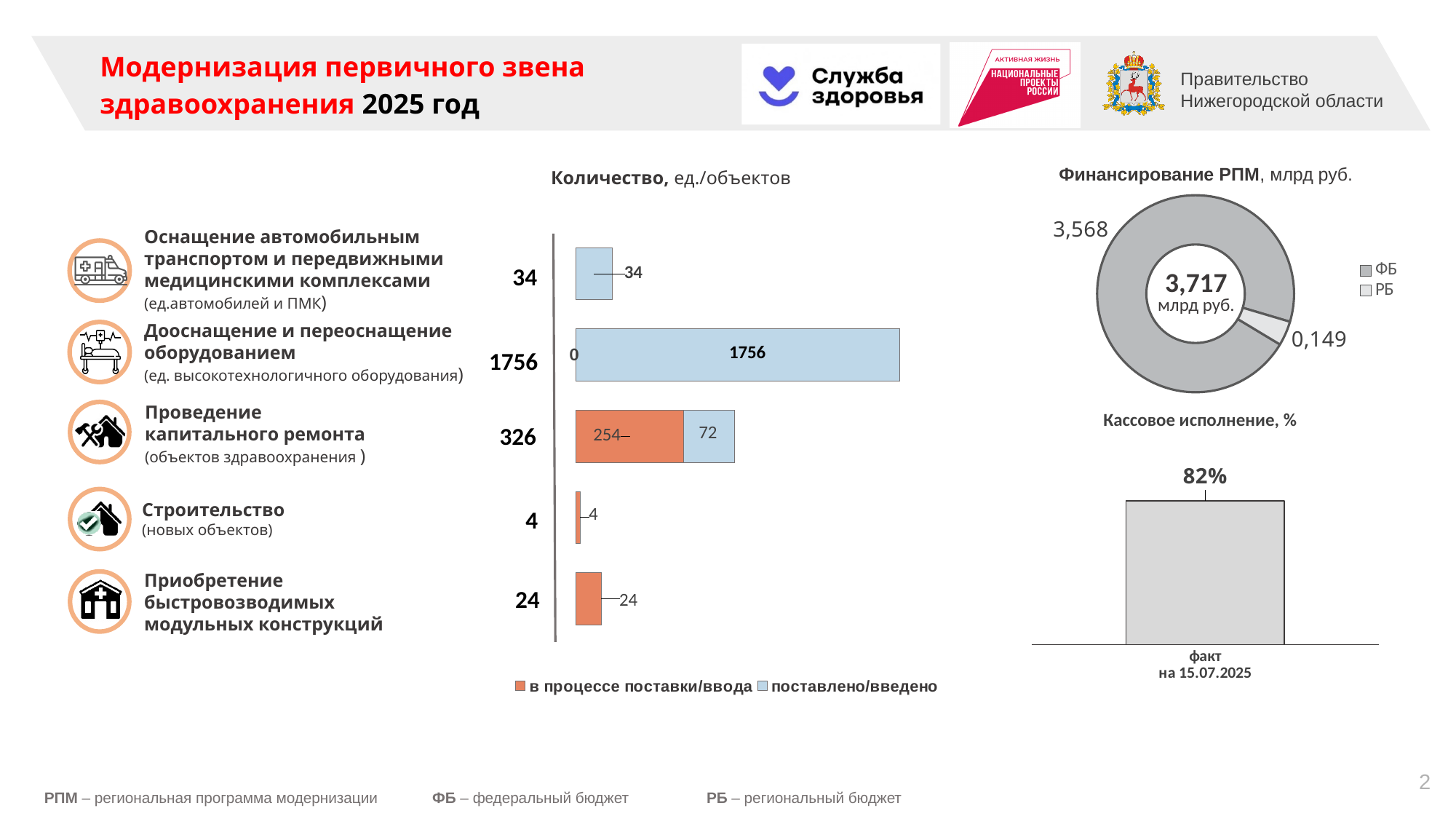
In the chart 'Финансирование РПМ, млрд руб.', what is the value for РБ? 0,149 In the chart 'Количество, ед./объектов', what is the difference between the 'в процессе поставки/ввода' and 'поставлено/введено' values for 'Проведение капитального ремонта'? 182 In the chart 'Количество, ед./объектов', what is the total of the stacked bar for 'Проведение капитального ремонта'? 326 In the chart 'Финансирование РПМ, млрд руб.', what total is shown in the centre of the donut? 3,717 млрд руб. In the chart 'Количество, ед./объектов', which category has the highest total value? Дооснащение и переоснащение оборудованием In the chart 'Количество, ед./объектов', what is the value for 'в процессе поставки/ввода' for 'Проведение капитального ремонта'? 254 In the chart 'Количество, ед./объектов', how many series does the legend list? 2 In the chart 'Количество, ед./объектов', what is the value for 'поставлено/введено' for 'Дооснащение и переоснащение оборудованием'? 1756 In the chart 'Кассовое исполнение, %', what is the value for 'факт на 15.07.2025'? 82% In the chart 'Количество, ед./объектов', what is the value for 'поставлено/введено' for 'Проведение капитального ремонта'? 72 In the chart 'Количество, ед./объектов', which category has the lowest total value? Строительство In the chart 'Финансирование РПМ, млрд руб.', what is the value for ФБ? 3,568